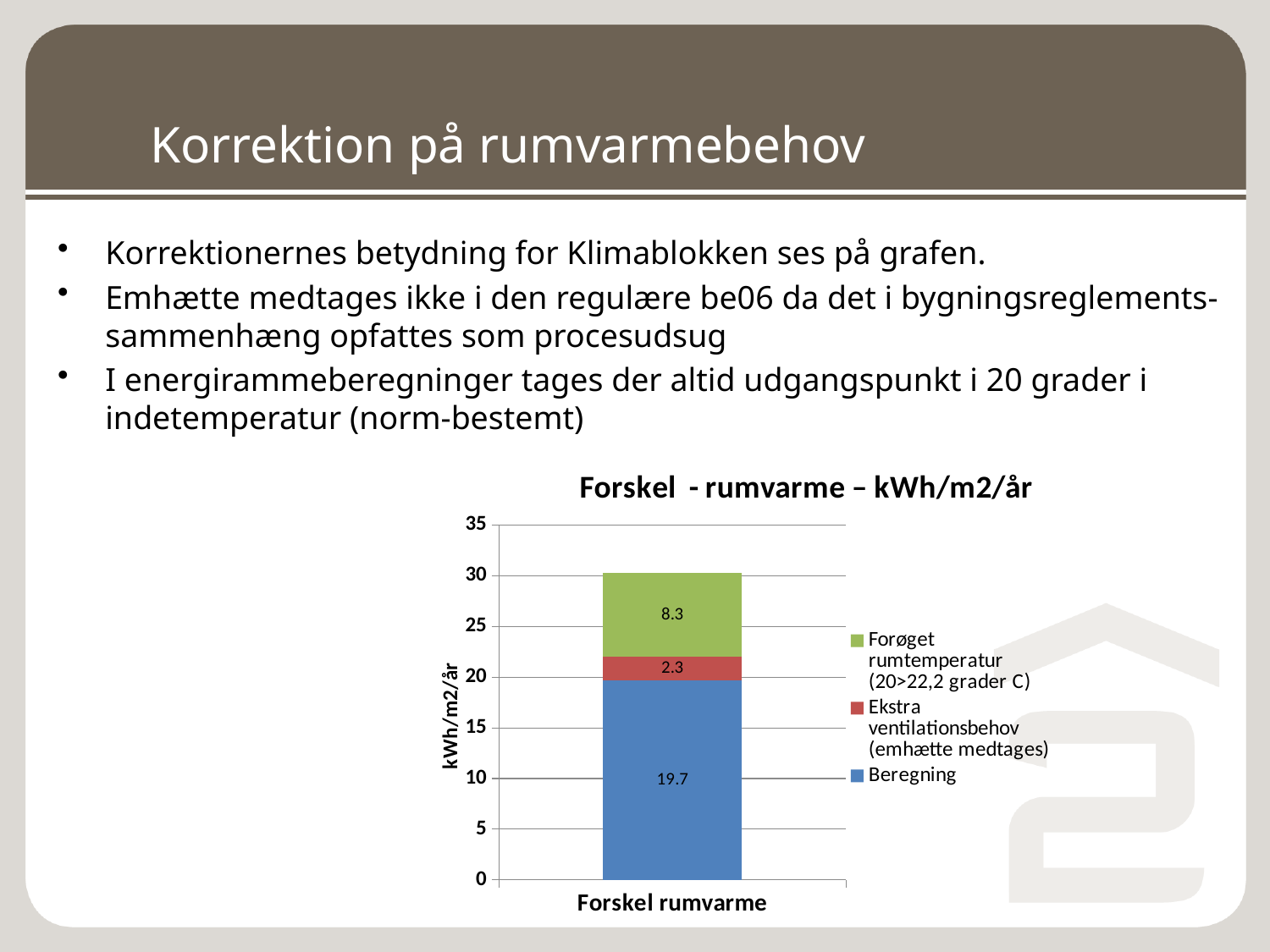
What is the title of the chart? Forskel - rumvarme – kWh/m2/år What kind of chart is shown on the slide? Stacked bar chart What is the value of the Ekstra ventilationsbehov (emhætte medtages) segment? 2.3 What is the difference between the Beregning segment and the Forøget rumtemperatur segment? 11.4 What is the value of the Forøget rumtemperatur (20>22,2 grader C) segment? 8.3 Which is larger, the Forøget rumtemperatur segment or the Ekstra ventilationsbehov segment? Forøget rumtemperatur (20>22,2 grader C) Which series has the smallest segment in the stacked bar? Ekstra ventilationsbehov (emhætte medtages) Which series has the largest segment in the stacked bar? Beregning Is the total of the stacked bar greater or less than 25? greater How many series does the legend list? 3 What is the total height of the stacked bar for Forskel rumvarme? 30.3 What is the value of the Beregning segment in the stacked bar? 19.7